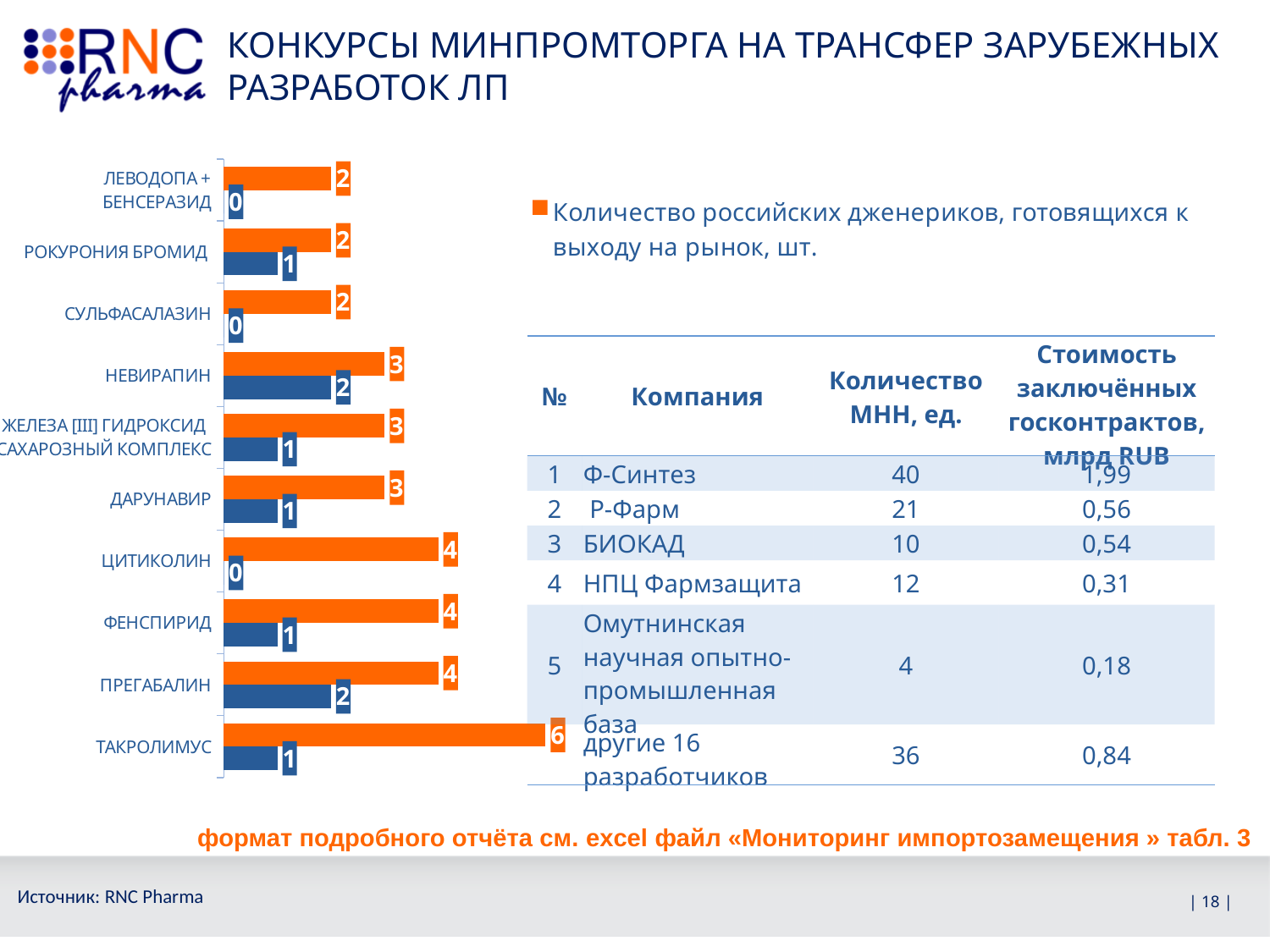
What is the value of the blue series for ЛЕВОДОПА + БЕНСЕРАЗИД? 0 What does the orange series in the legend represent? Количество российских дженериков, готовящихся к выходу на рынок, шт. What is the value of the blue series for ПРЕГАБАЛИН? 2 How many drug categories are plotted on the bar chart? 10 What is the value of the orange series for ЦИТИКОЛИН? 4 What type of chart is shown on the left of the slide? bar chart Which is larger: the orange value for НЕВИРАПИН or the orange value for СУЛЬФАСАЛАЗИН? НЕВИРАПИН Which drug has the highest value in the orange series? ТАКРОЛИМУС Which drug has the highest value in the blue series? НЕВИРАПИН and ПРЕГАБАЛИН (both 2) What is the value of the orange series (Количество российских дженериков, готовящихся к выходу на рынок) for ТАКРОЛИМУС? 6 What is the difference between the orange values for ТАКРОЛИМУС and ФЕНСПИРИД? 2 What is the difference between the orange and blue values for ТАКРОЛИМУС? 5